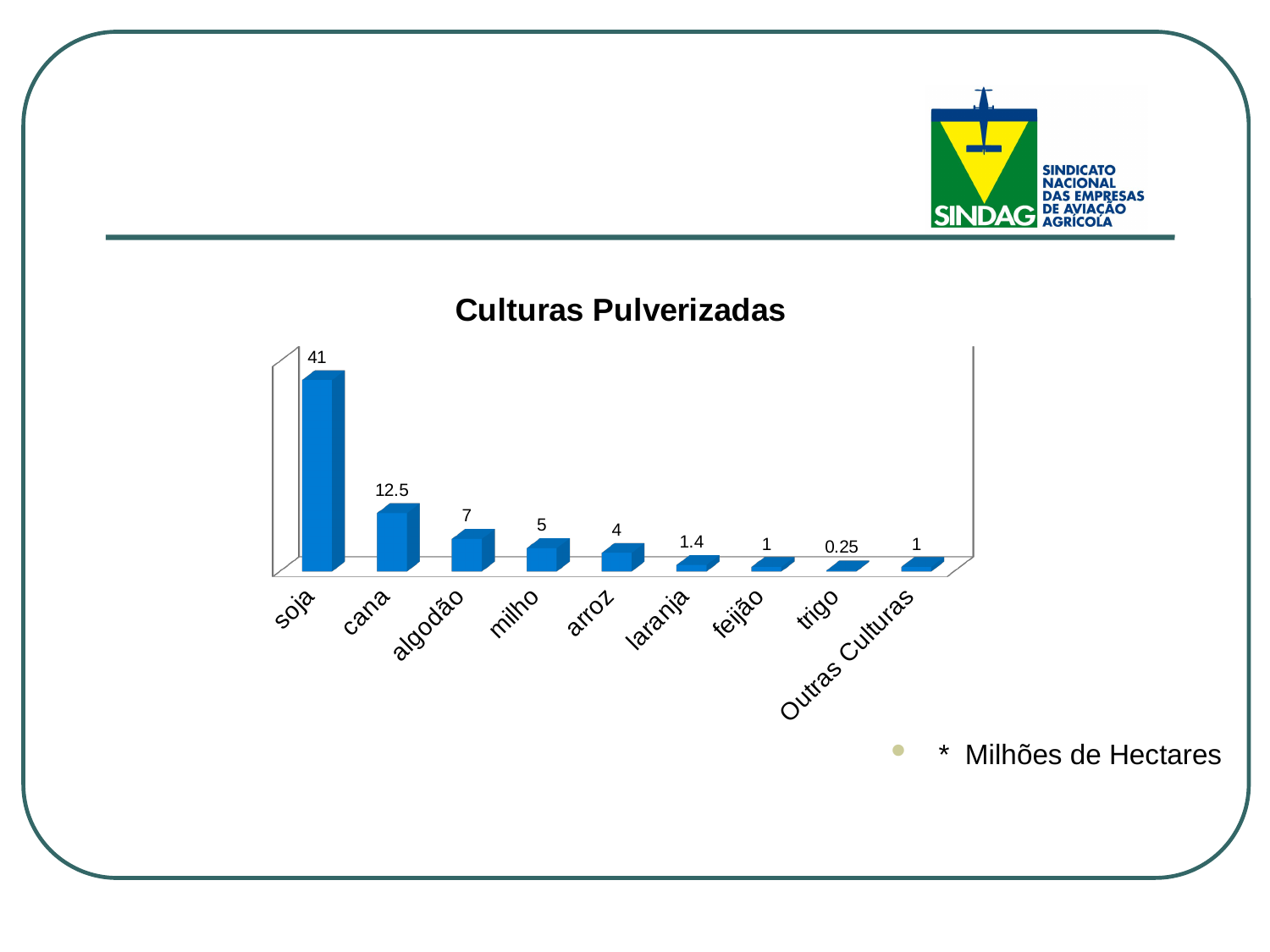
What is the value for laranja? 1.4 What is the title of the chart? Culturas Pulverizadas What is the difference between the values for soja and cana? 28.5 How many categories are shown in the chart? 9 What is the value for cana? 12.5 What kind of chart is shown on the slide? bar chart Which category has the highest value? soja What is the difference between the values for algodão and milho? 2 What is the value for trigo? 0.25 Which is larger, the value for milho or the value for arroz? milho What is the value for soja? 41 Which category has the lowest value? trigo